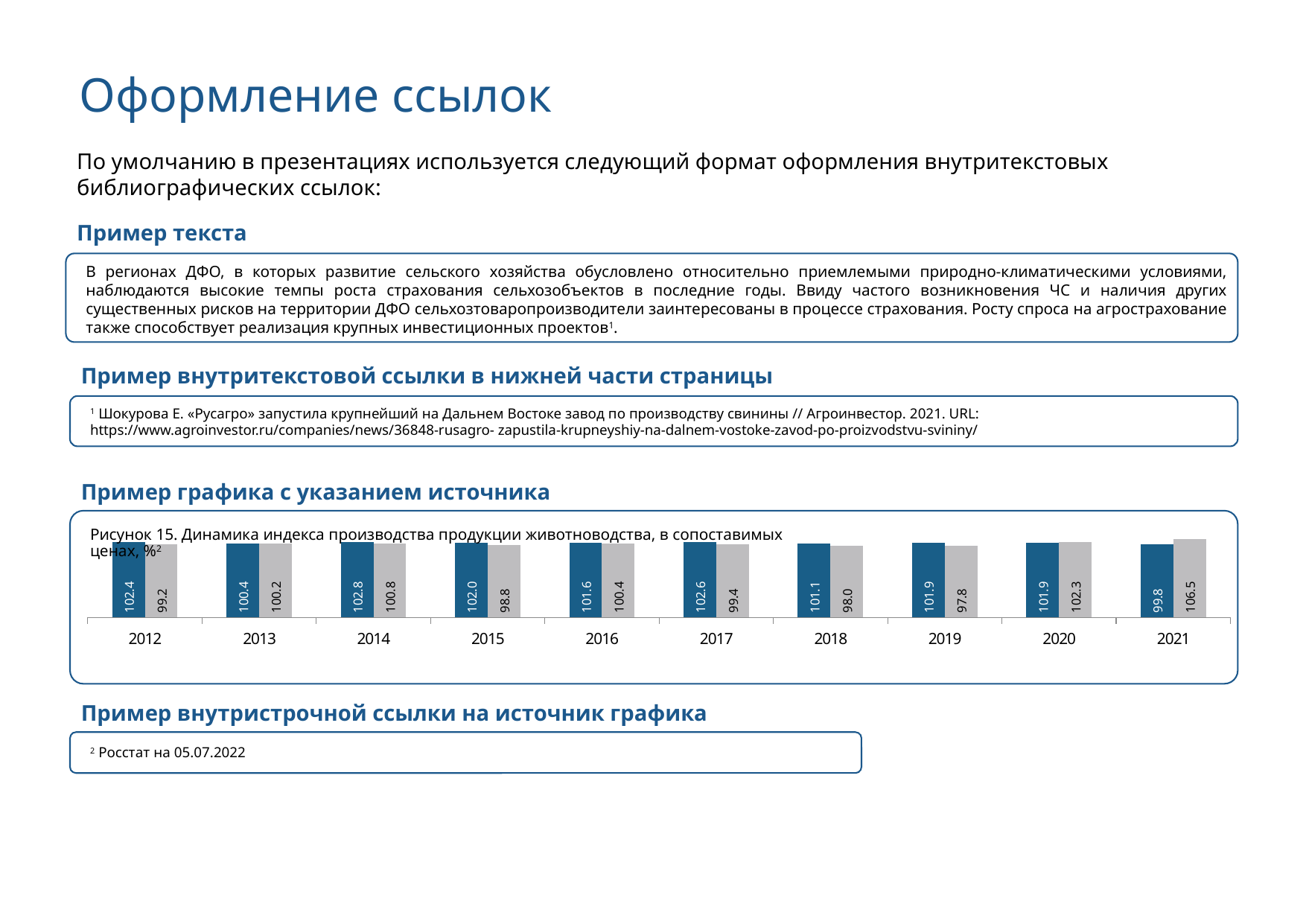
What kind of chart is shown on the slide? bar chart What is the difference between the blue and grey bars for 2021? 6.7 What is the value of the grey bar for 2021? 106.5 What is the difference between the blue and grey bars for 2019? 4.1 In which year is the grey bar highest? 2021 How many years are shown on the x axis of the chart? 10 For 2020, which bar is larger, the blue or the grey? grey What is the value of the blue bar for 2012? 102.4 In which year is the blue bar lowest? 2021 What is the value of the grey bar for 2019? 97.8 What is the value of the blue bar for 2018? 101.1 In which year is the grey bar lowest? 2019